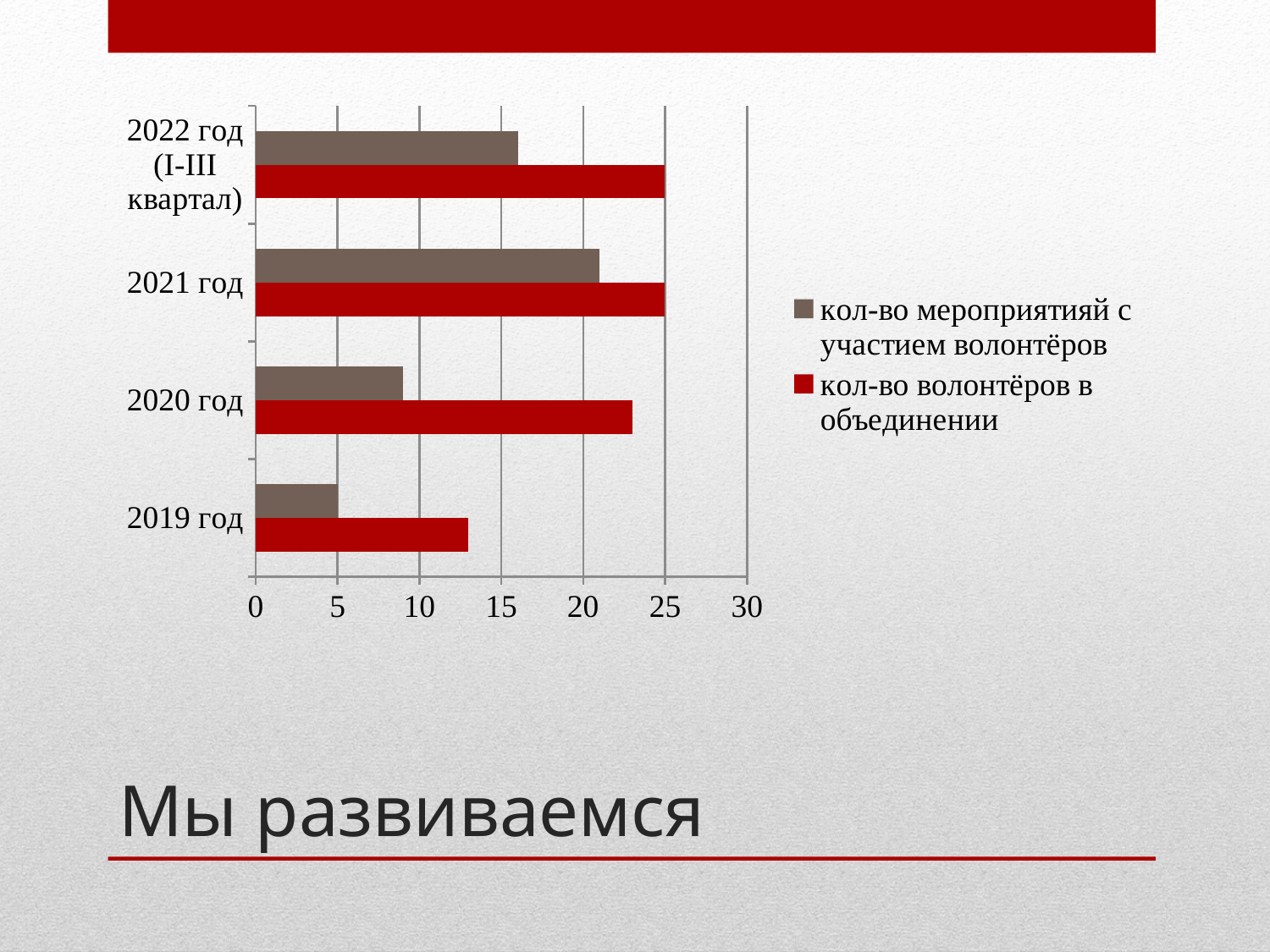
Is the value of "кол-во волонтёров в объединении" for 2020 год greater or less than 20? greater How many year categories are shown on the chart? 4 What kind of chart is shown on the slide? bar chart Does "кол-во волонтёров в объединении" rise or fall from 2019 год to 2021 год? rise How many series does the legend list? 2 What is the value of "кол-во мероприятияй с участием волонтёров" for 2019 год? 5 Which year has the lowest value for "кол-во волонтёров в объединении"? 2019 год Which year has the highest value for "кол-во мероприятияй с участием волонтёров"? 2021 год Is the value of "кол-во мероприятияй с участием волонтёров" for 2020 год greater or less than 10? less What is the value of "кол-во волонтёров в объединении" for 2022 год (I-III квартал)? 25 What is the value of "кол-во волонтёров в объединении" for 2021 год? 25 Which is larger: "кол-во мероприятияй с участием волонтёров" for 2020 год or for 2022 год (I-III квартал)? 2022 год (I-III квартал)